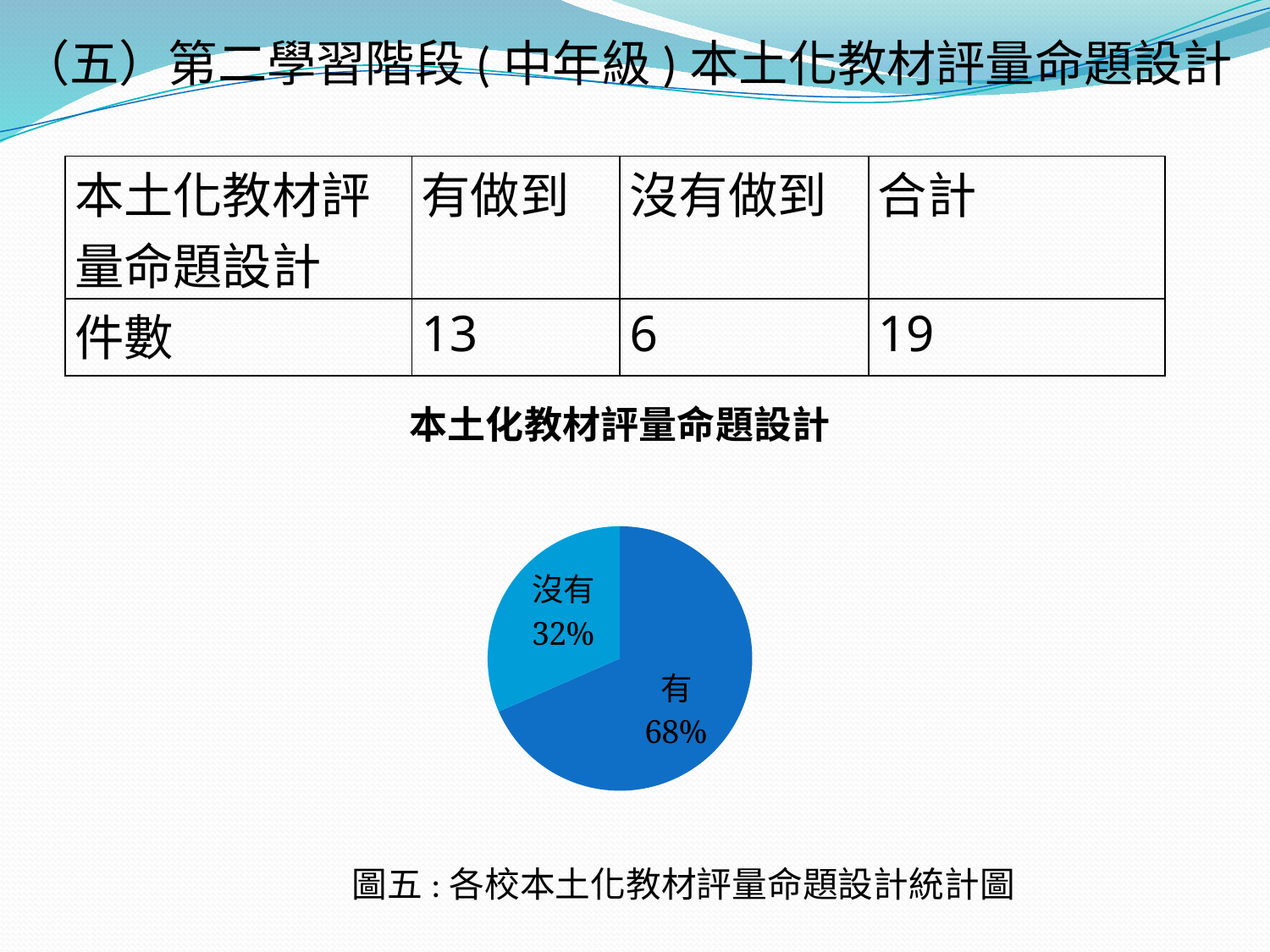
What is the title of the chart? 本土化教材評量命題設計 How many slices does the pie chart have? 2 What share of the pie does the 有 slice represent? 68% What percentage does the 沒有 slice show? 32% Is the share of the 沒有 slice greater or less than 50%? less What percentage does the 有 slice show? 68% Which slice is the smallest in the pie chart? 沒有 What is the difference in percentage points between the 有 slice and the 沒有 slice? 36 What type of chart is shown on the slide? pie chart What is the caption below the chart? 圖五 : 各校本土化教材評量命題設計統計圖 Which slice is larger, 有 or 沒有? 有 Which slice is the largest in the pie chart? 有